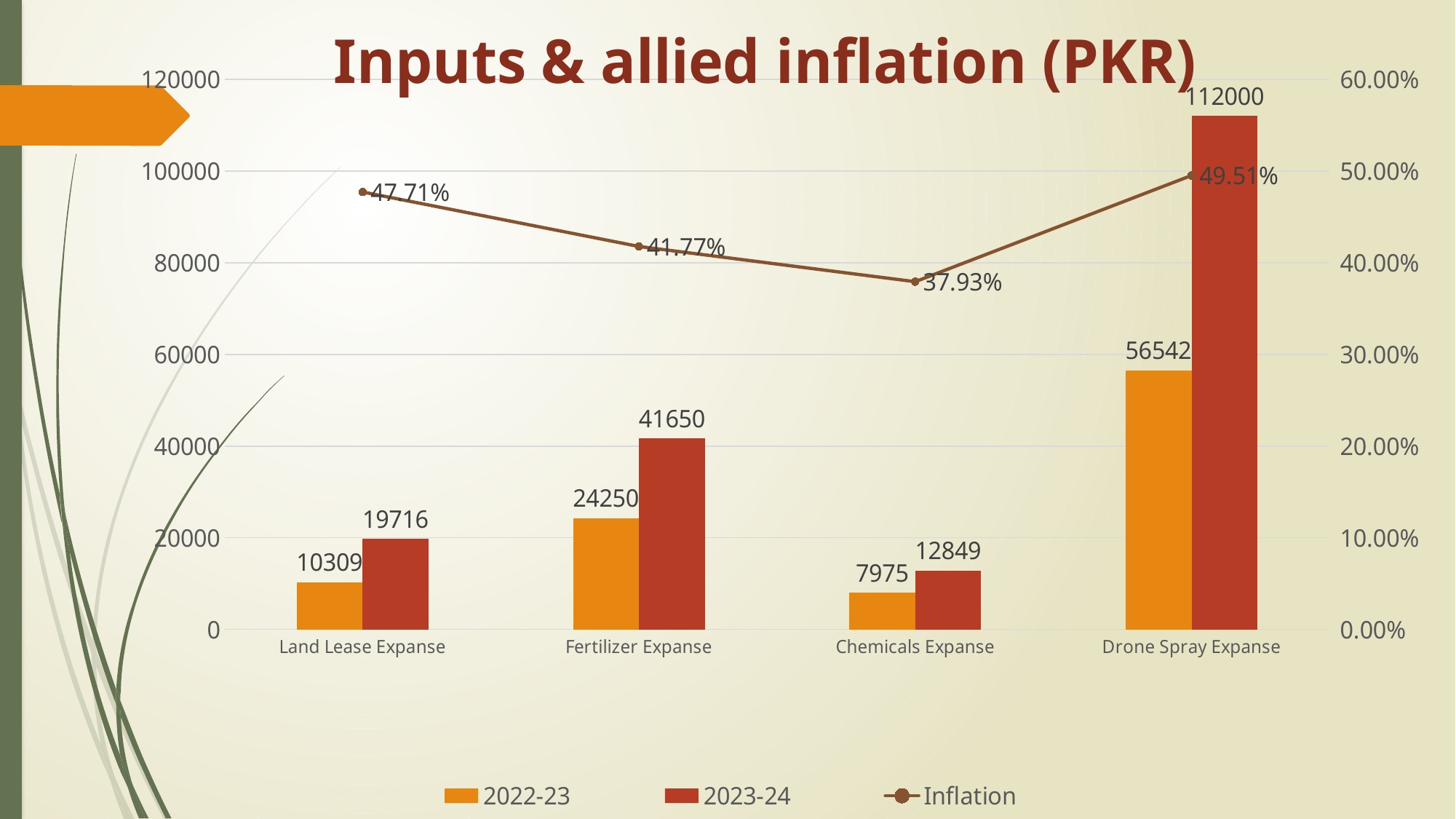
What is the Inflation value for Chemicals Expanse? 37.93% Which category has the highest Inflation value? Drone Spray Expanse What kind of chart is this? Combined bar and line chart Which is larger: the 2023-24 value for Chemicals Expanse or the 2022-23 value for Fertilizer Expanse? 2022-23 value for Fertilizer Expanse How many series does the legend list? 3 What is the difference between the 2023-24 and 2022-23 values for Fertilizer Expanse? 17400 How many categories are shown on the x axis? 4 Which category has the lowest 2022-23 value? Chemicals Expanse What is the title of the chart? Inputs & allied inflation (PKR) What is the 2022-23 value for Fertilizer Expanse? 24250 What is the 2023-24 value for Land Lease Expanse? 19716 What is the 2023-24 value for Drone Spray Expanse? 112000